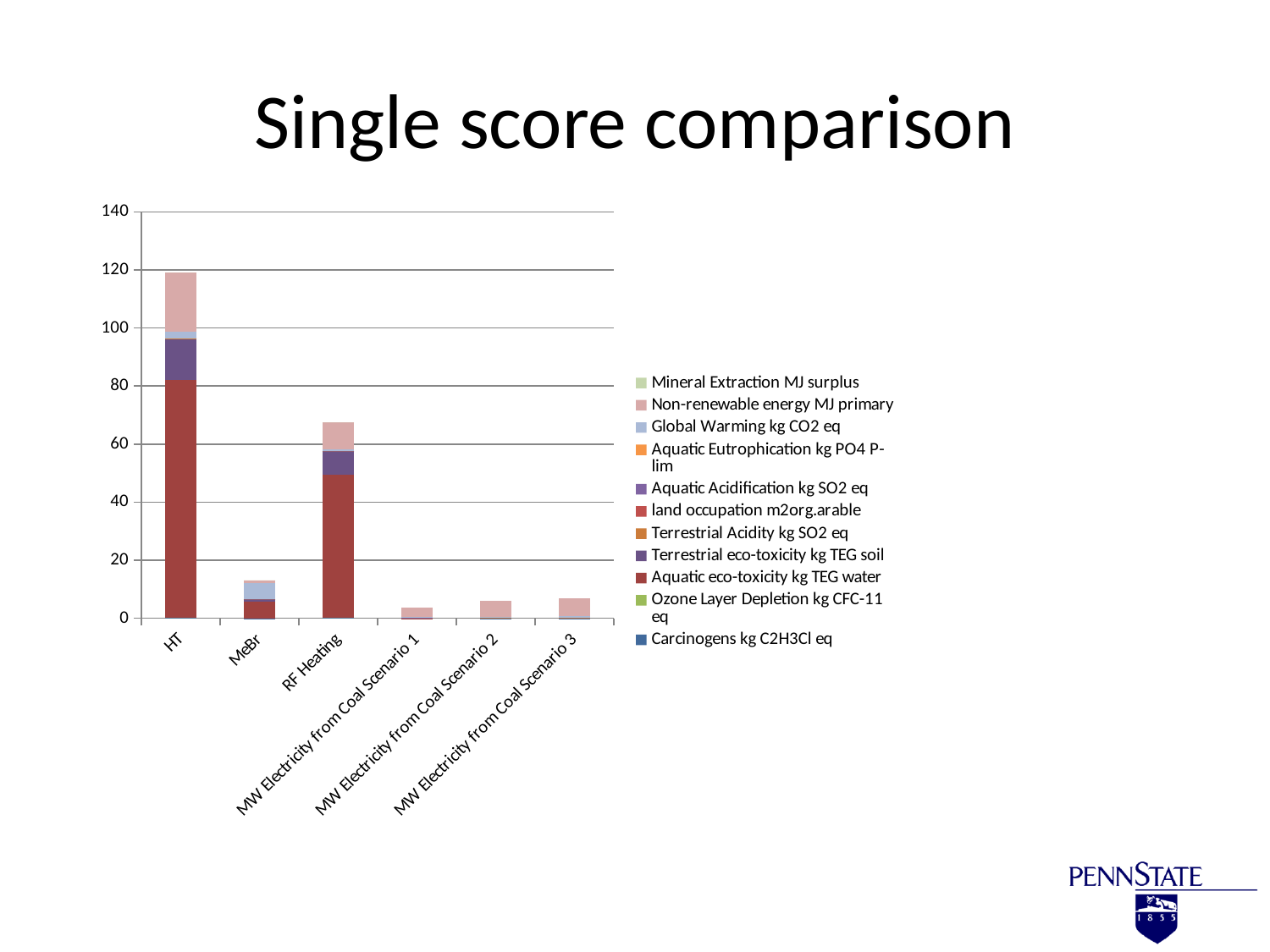
Which series makes up the largest portion of the HT bar? Aquatic eco-toxicity kg TEG water How many series does the legend list? 11 Is the total stacked value for HT greater or less than 100? greater Which category has the shortest stacked bar? MW Electricity from Coal Scenario 1 Which has a larger total stacked value, HT or RF Heating? HT Is the total stacked value for MeBr greater or less than 20? less Which category has the tallest stacked bar? HT What kind of chart is shown on the slide? Stacked bar chart How many categories are shown on the x axis of the chart? 6 Is the total stacked value for RF Heating greater or less than 60? greater Which has a larger total stacked value, MeBr or MW Electricity from Coal Scenario 1? MeBr What is the title of the slide? Single score comparison